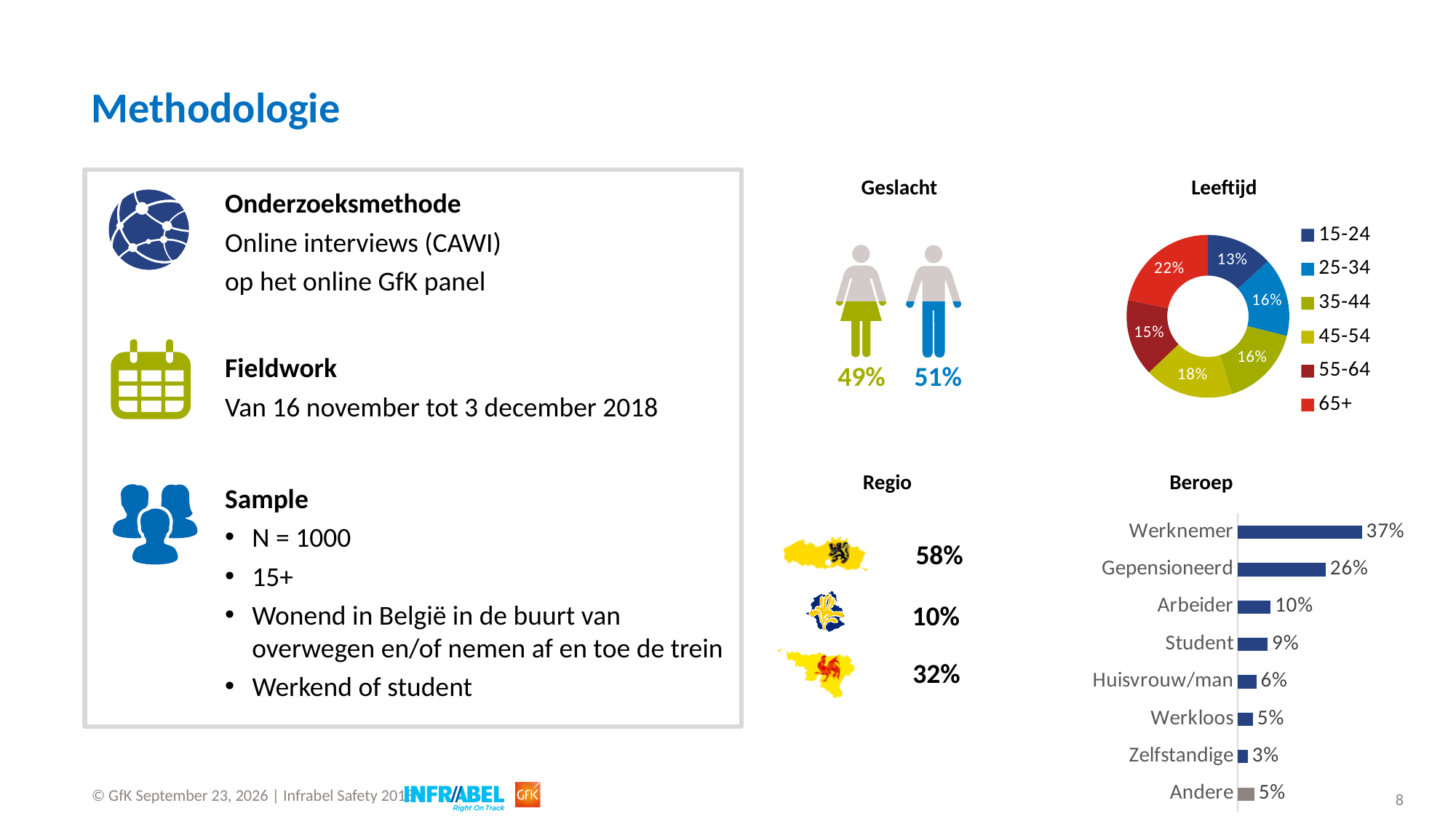
In the Leeftijd chart, which age group has the smallest share? 15-24 What kind of chart is the Leeftijd chart? Donut chart In the Leeftijd chart, which age group has the largest share? 65+ In the Leeftijd chart, what percentage is shown for the 65+ age group? 22% In the Beroep chart, which category has the lowest value? Zelfstandige What kind of chart is the Beroep chart? Bar chart In the Leeftijd chart, what percentage is shown for the 45-54 age group? 18% In the Leeftijd chart, how many age groups does the legend list? 6 In the Beroep chart, what is the value for Gepensioneerd? 26% In the Beroep chart, which category has the highest value? Werknemer In the Beroep chart, how many categories are shown? 8 In the Beroep chart, what is the difference between Werknemer and Gepensioneerd? 11%